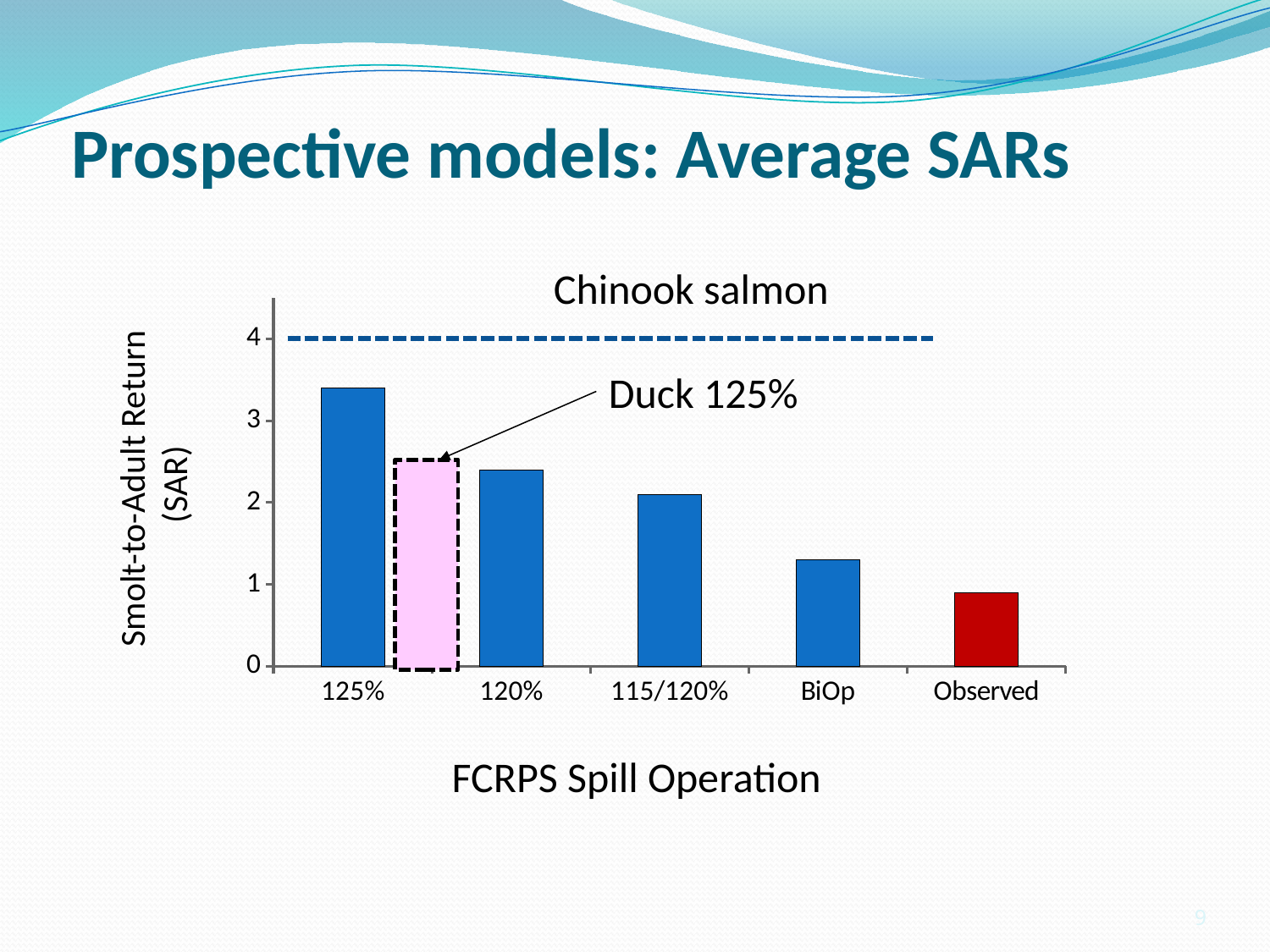
At what y-axis value is the horizontal dashed line drawn? 4 What is the title of the chart? Chinook salmon What kind of chart is shown on the slide? bar chart Is the value for BiOp greater or less than 1? greater How many categories are labeled on the x axis? 5 Is the value for Observed greater or less than 1? less Do the bar values rise or fall from left to right along the x axis? fall Which category has the lowest Smolt-to-Adult Return? Observed Which is larger, the value for 120% or the value for BiOp? 120% Is the value for 115/120% greater or less than 2? greater Which FCRPS spill operation has the highest Smolt-to-Adult Return? 125%